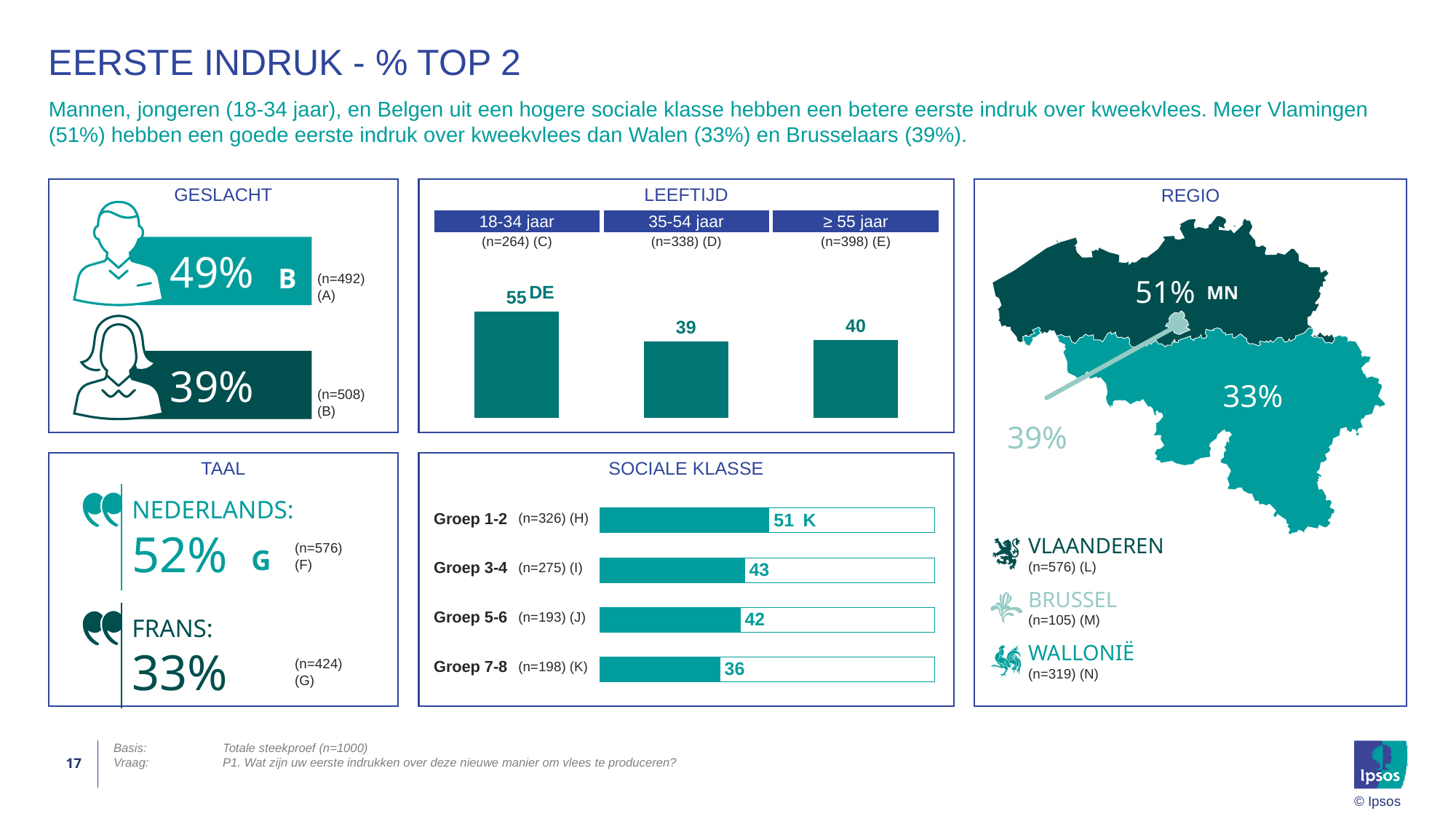
In the LEEFTIJD chart, what is the value for 18-34 jaar? 55 In the GESLACHT panel, which value is larger, the one for men (A) or the one for women (B)? Men (A), 49% In the SOCIALE KLASSE chart, what is the value for Groep 3-4? 43 In the LEEFTIJD chart, which age group has the highest value? 18-34 jaar In the SOCIALE KLASSE chart, which group has the lowest value? Groep 7-8 In the SOCIALE KLASSE chart, what is the difference between Groep 1-2 and Groep 7-8? 15 What kind of chart is the LEEFTIJD chart? Bar chart In the LEEFTIJD chart, which age group has the lowest value? 35-54 jaar In the LEEFTIJD chart, what is the value for 35-54 jaar? 39 In the SOCIALE KLASSE chart, do the values rise or fall from Groep 1-2 down to Groep 7-8? Fall In the LEEFTIJD chart, how many bars are plotted? 3 In the LEEFTIJD chart, what is the difference between the values for 18-34 jaar and ≥ 55 jaar? 15